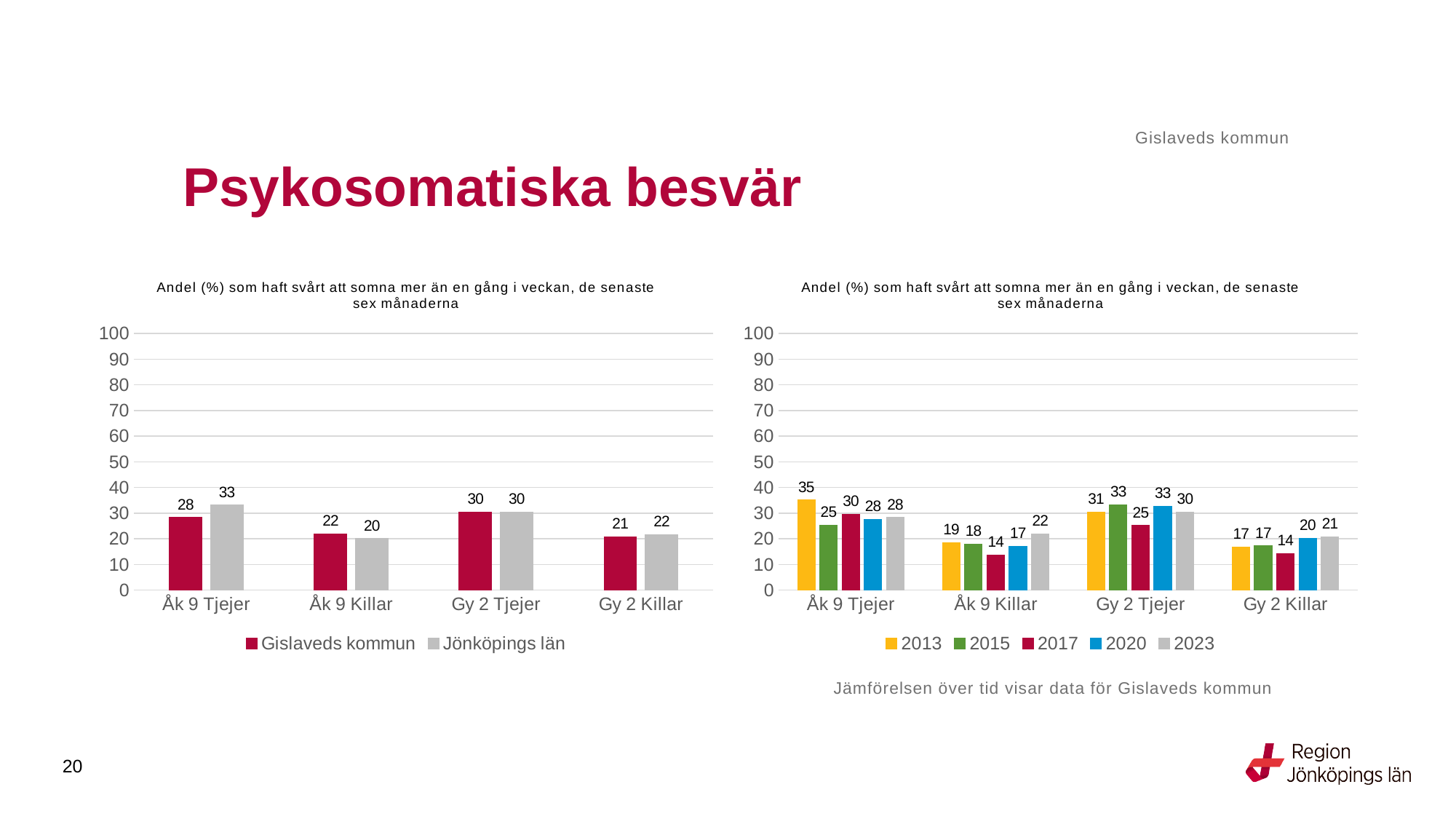
In the left chart, what is the value for Gislaveds kommun for Åk 9 Tjejer? 28 In the right chart, how many series does the legend list? 5 What kind of chart is the left chart? Bar chart In the right chart, what is the difference between the 2013 and 2023 values for Åk 9 Tjejer? 7 In the left chart, which category has the lowest value for Jönköpings län? Åk 9 Killar In the left chart, what is the value for Jönköpings län for Gy 2 Killar? 22 In the right chart, which year has the highest value for Gy 2 Tjejer? 2015 and 2020 (both 33) In the left chart, what is the difference between Jönköpings län and Gislaveds kommun for Åk 9 Tjejer? 5 In the left chart, how many series does the legend list? 2 In the right chart, what is the value for 2017 for Gy 2 Killar? 14 In the right chart, what is the value for 2013 for Åk 9 Tjejer? 35 In the right chart, is the value for 2023 for Åk 9 Killar larger than the value for 2017 for Åk 9 Killar? Yes